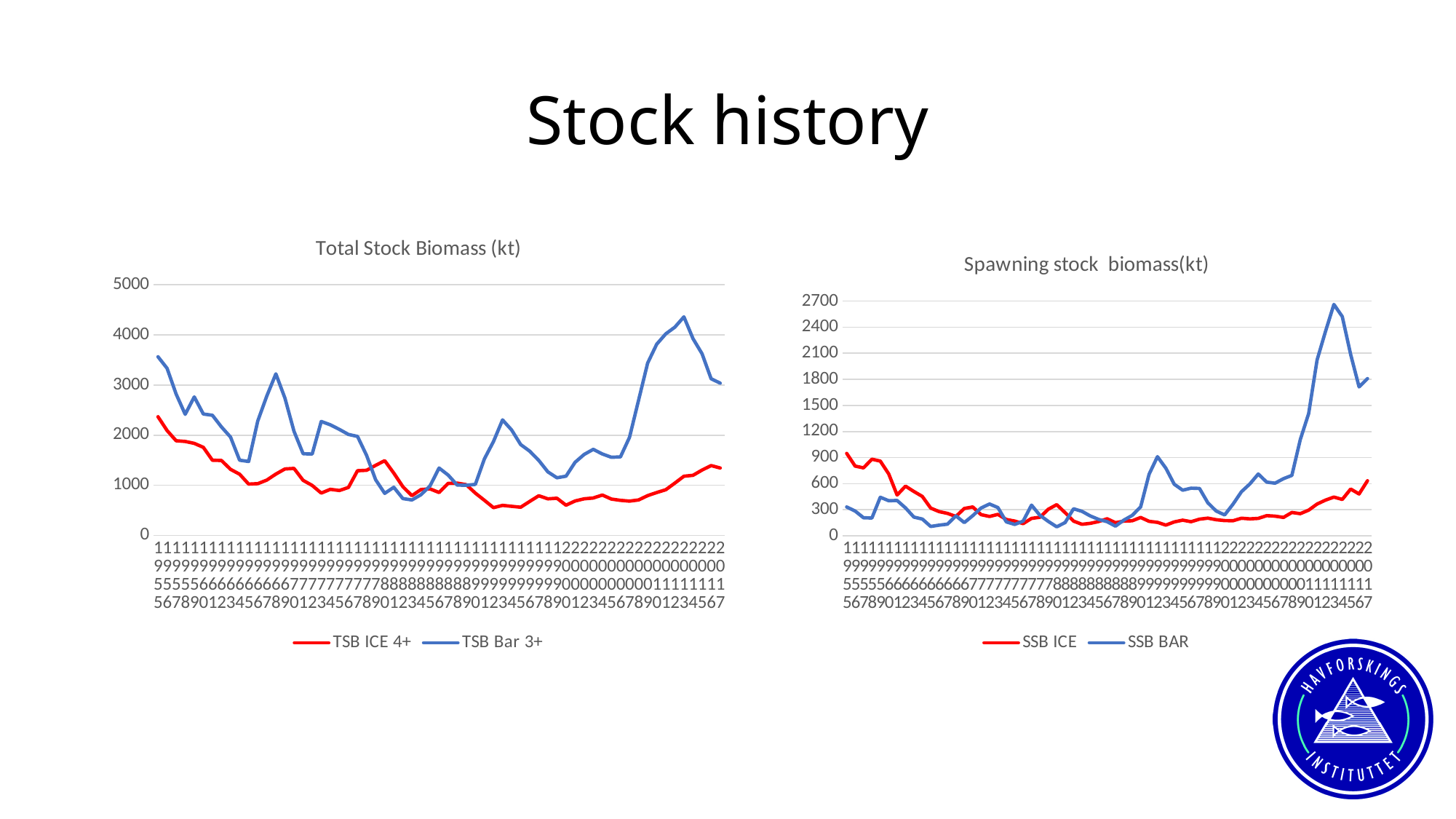
In the Total Stock Biomass (kt) chart, which series is drawn in red? TSB ICE 4+ In the Spawning stock biomass(kt) chart, which series reaches the highest peak? SSB BAR In the Total Stock Biomass (kt) chart, is the first value of TSB ICE 4+ greater or less than 2000? greater In the Spawning stock biomass(kt) chart, is the first value of SSB ICE greater or less than 600? greater How many series does the legend of the Total Stock Biomass (kt) chart list? 2 How many series does the legend of the Spawning stock biomass(kt) chart list? 2 In the Spawning stock biomass(kt) chart, which series is drawn in blue? SSB BAR In the Spawning stock biomass(kt) chart, is the peak value of SSB BAR greater or less than 2400? greater What kind of chart is the Total Stock Biomass (kt) chart? line chart In the Total Stock Biomass (kt) chart, which series reaches the highest peak? TSB Bar 3+ In the Total Stock Biomass (kt) chart, does TSB ICE 4+ rise or fall over the first ten years shown? fall